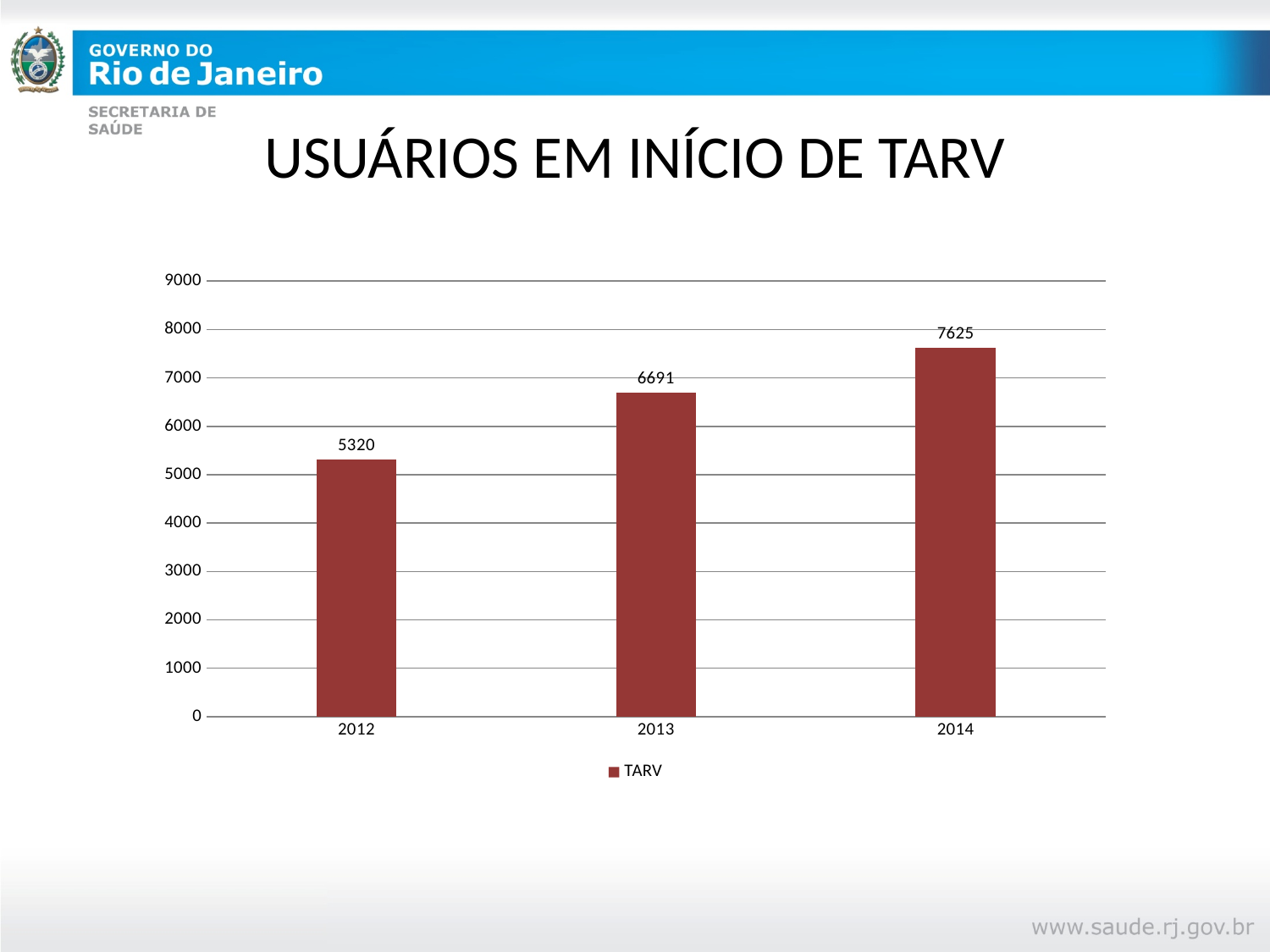
What kind of chart is shown on the slide? bar chart What is the value for 2014? 7625 How many years are shown on the x axis? 3 Which is larger, the value for 2013 or the value for 2014? 2014 Which year has the lowest value? 2012 Is the value for 2013 greater or less than 6000? greater What is the difference between the values for 2013 and 2012? 1371 What is the value for 2012? 5320 Which year has the highest value? 2014 What is the value for 2013? 6691 What is the difference between the values for 2014 and 2012? 2305 Do the values rise or fall from 2012 to 2014? rise